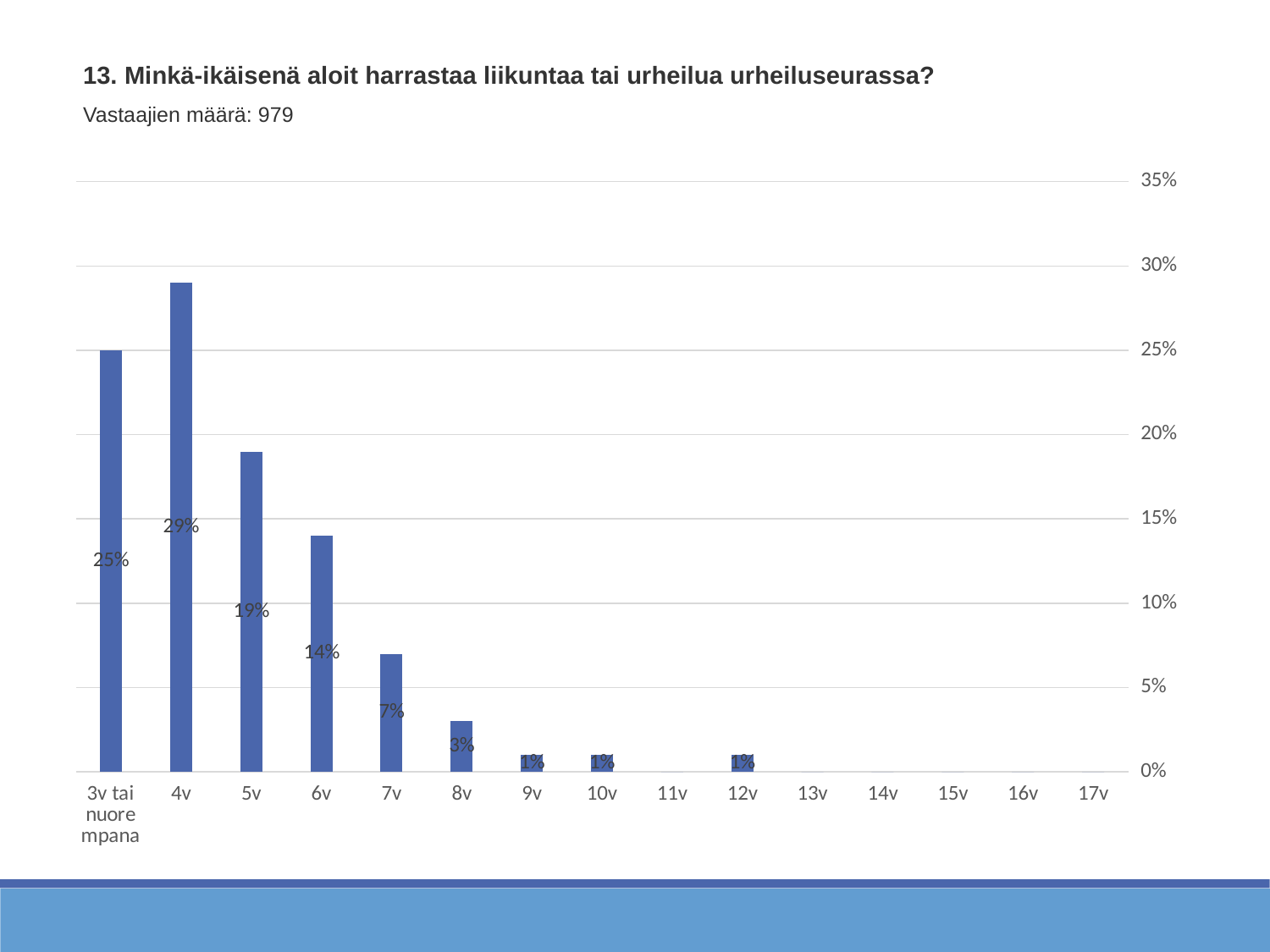
What is the difference between the values for 4v and 5v? 10% What kind of chart is shown on the slide? bar chart What is the value for 8v? 3% What percentage is shown for 6v? 14% Is the value for 7v greater or less than 10%? less What is the value shown for the category 3v tai nuorempana? 25% Do the values rise or fall along the x axis from 4v to 8v? fall What percentage of respondents started at age 4v? 29% Which is larger, the value for 3v tai nuorempana or the value for 5v? 3v tai nuorempana Which age category has the highest percentage? 4v How many age categories are listed on the x axis? 15 What is the difference between the values for 6v and 7v? 7%